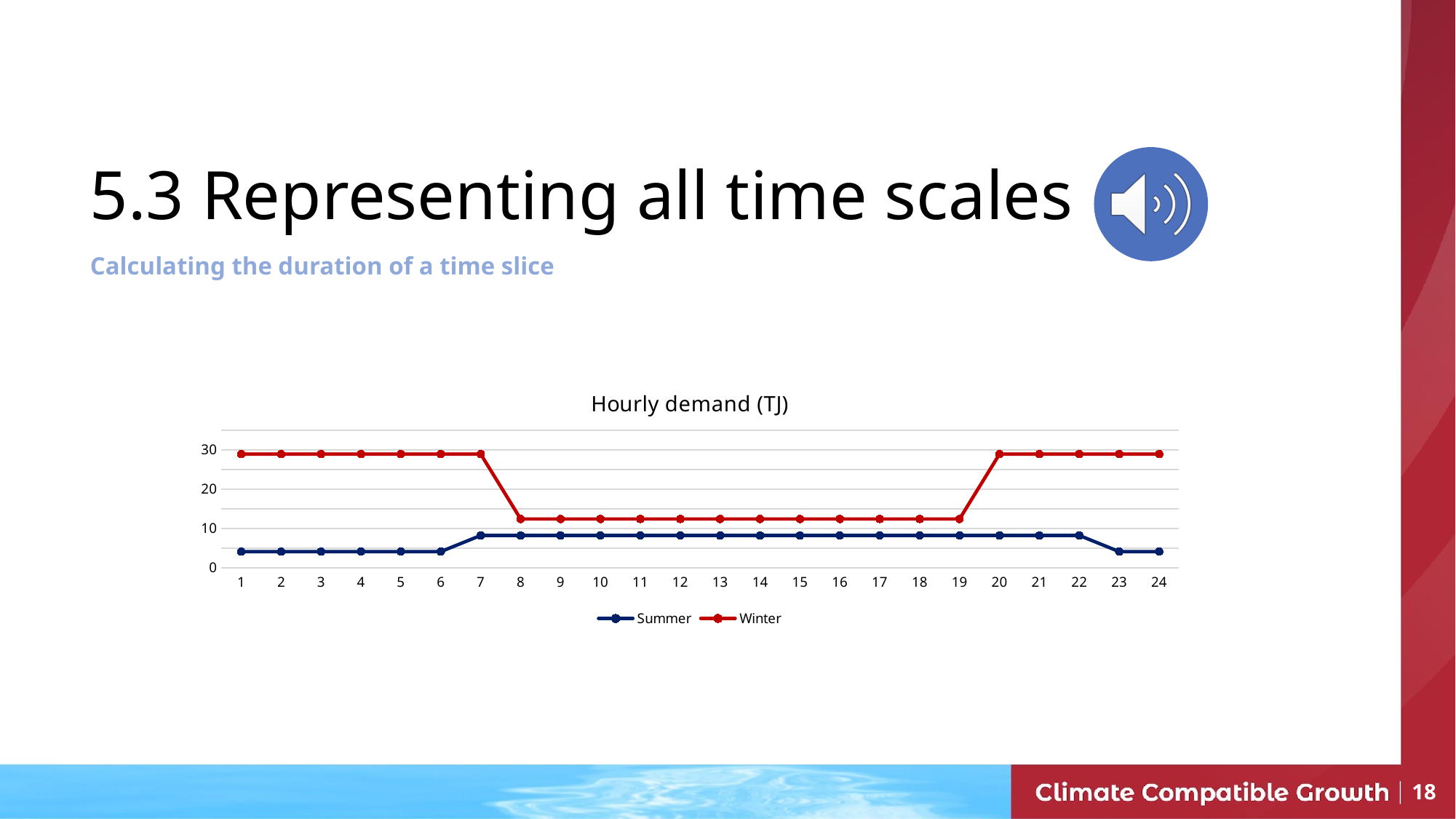
What is the title of the chart? Hourly demand (TJ) Is the Winter value at hour 3 greater or less than 20? greater What kind of chart is shown on the slide? line chart How many hours are plotted along the x axis? 24 Which series is drawn in red? Winter At hour 5, which series has the higher value, Summer or Winter? Winter Is the Winter value at hour 12 greater or less than 20? less Does the Summer line rise or fall between hour 6 and hour 7? rise Is the Winter value at hour 15 greater or less than 10? greater Does the Winter line rise or fall between hour 7 and hour 8? fall How many series does the legend list? 2